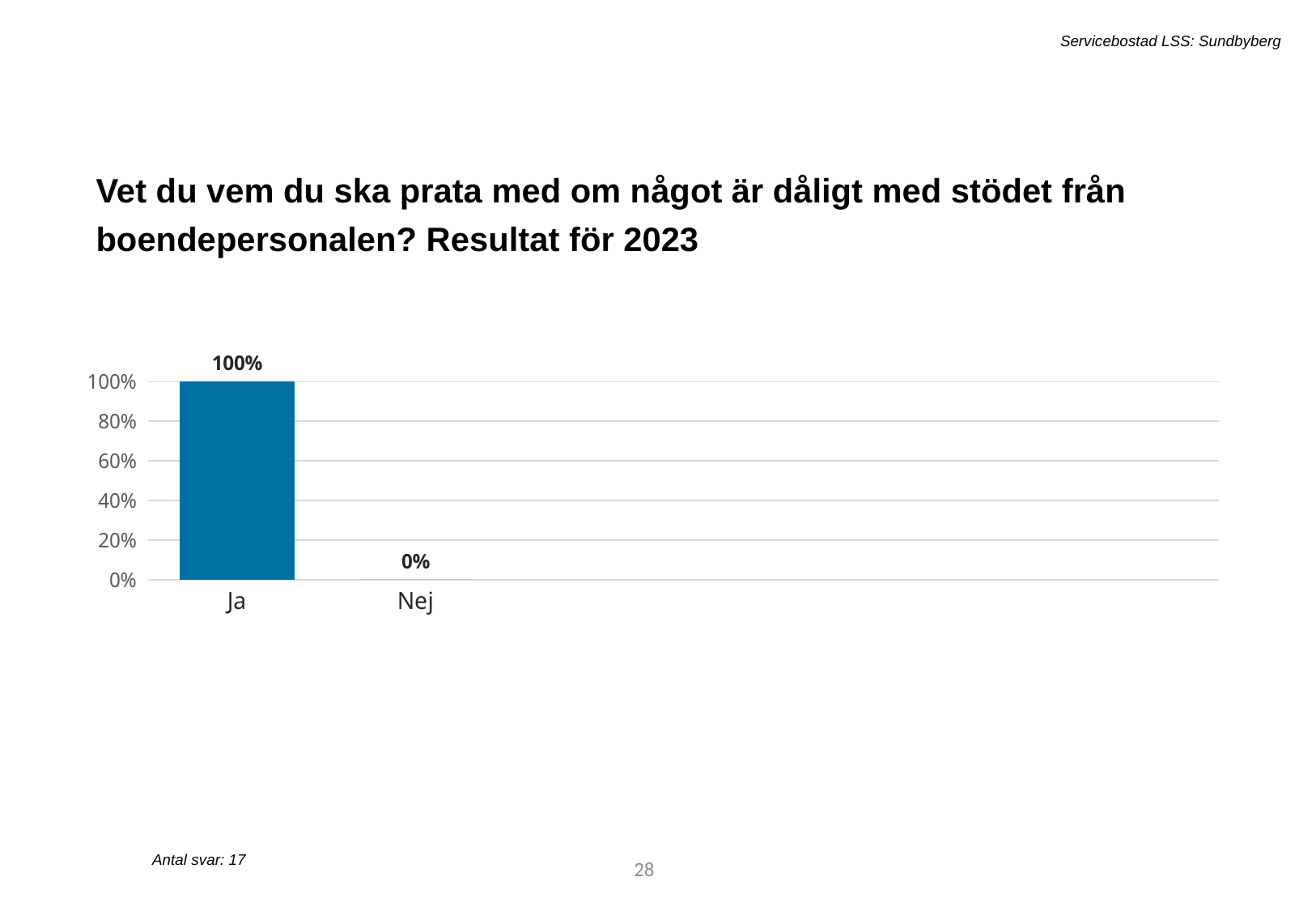
How many categories are shown on the x axis? 2 What is the number of responses (Antal svar) stated on the slide? 17 Which category has the lowest value? Nej What is the value for Nej? 0% Which is larger, the value for Ja or the value for Nej? Ja What kind of chart is shown on the slide? bar chart What is the highest value shown on the y axis? 100% Is the value for Nej greater or less than 20%? less What is the value for Ja? 100% Which category has the highest value? Ja What is the difference between the values for Ja and Nej? 100% Is the value for Ja greater or less than 80%? greater